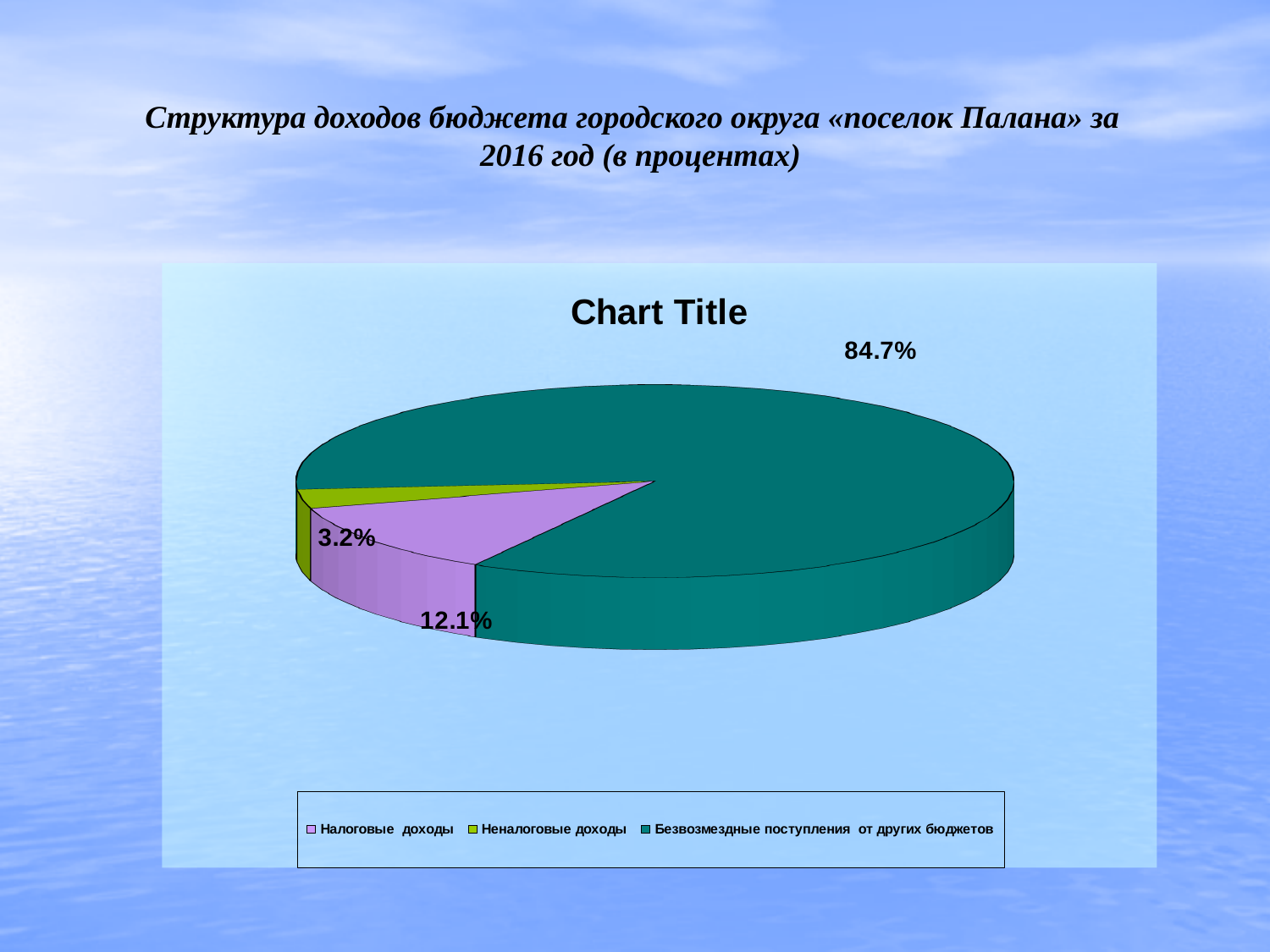
What share of the pie is labelled for Налоговые доходы? 12.1% What colour is the slice for Безвозмездные поступления от других бюджетов? Teal (green) Which category has the largest slice of the pie? Безвозмездные поступления от других бюджетов How many slices does the pie chart have? 3 What is the difference in percentage points between Безвозмездные поступления от других бюджетов and Налоговые доходы? 72.6 What share of the pie is labelled for Безвозмездные поступления от других бюджетов? 84.7% Which category has the smallest slice of the pie? Неналоговые доходы What kind of chart is shown on the slide? Pie chart What share of the pie is labelled for Неналоговые доходы? 3.2% Which is larger, the slice for Налоговые доходы or the slice for Неналоговые доходы? Налоговые доходы How many entries does the legend list? 3 What is the difference in percentage points between Налоговые доходы and Неналоговые доходы? 8.9